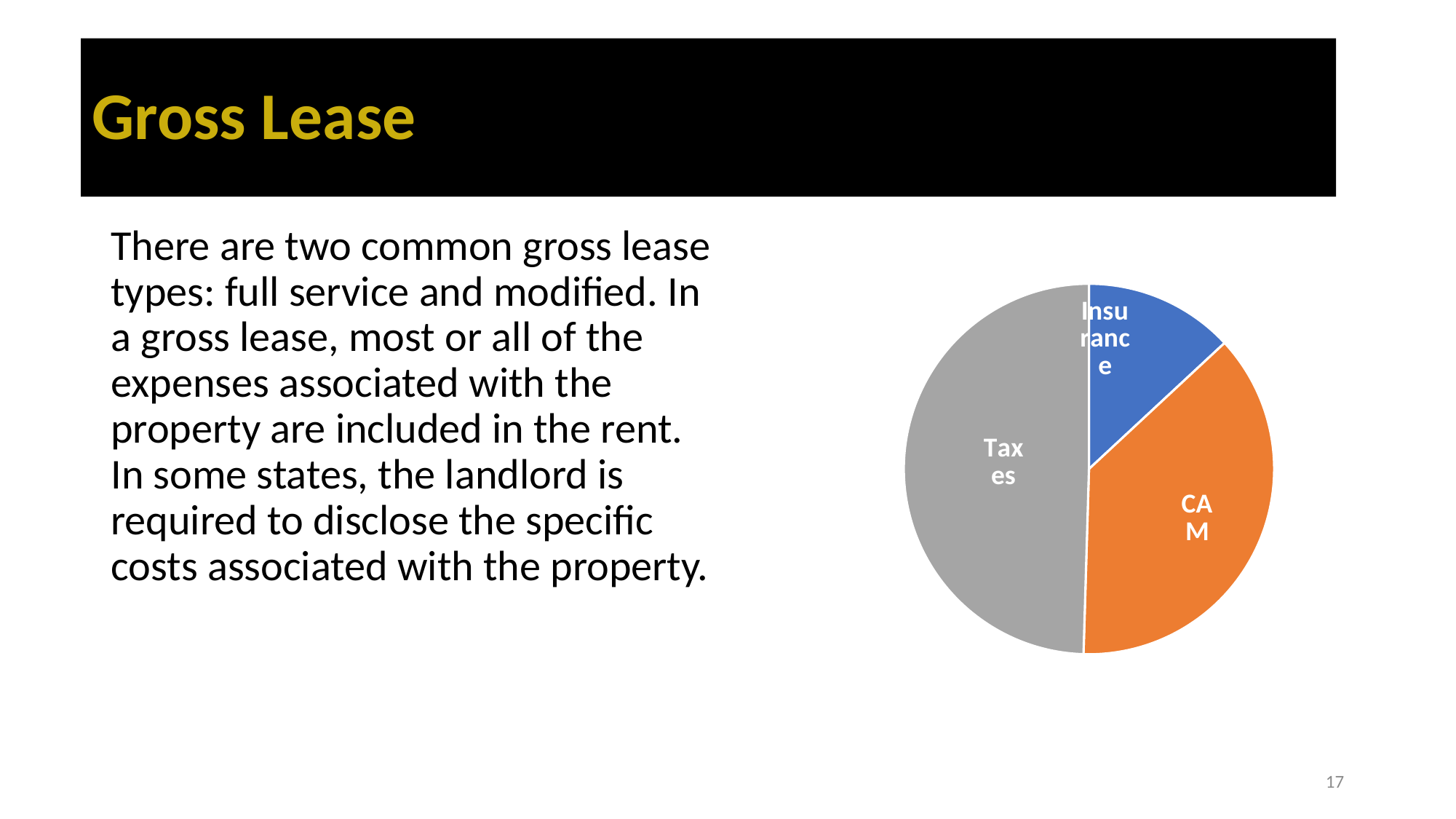
Which slice is smaller in the pie chart, Insurance or Taxes? Insurance Which slice is larger in the pie chart, Taxes or CAM? Taxes Which slice of the pie chart is the largest? Taxes Which slice is larger in the pie chart, CAM or Insurance? CAM What colour is the Taxes slice in the pie chart? gray Which slice of the pie chart is the smallest? Insurance What kind of chart is shown on the slide? pie chart Which slice of the pie chart is coloured orange? CAM How many slices does the pie chart have? 3